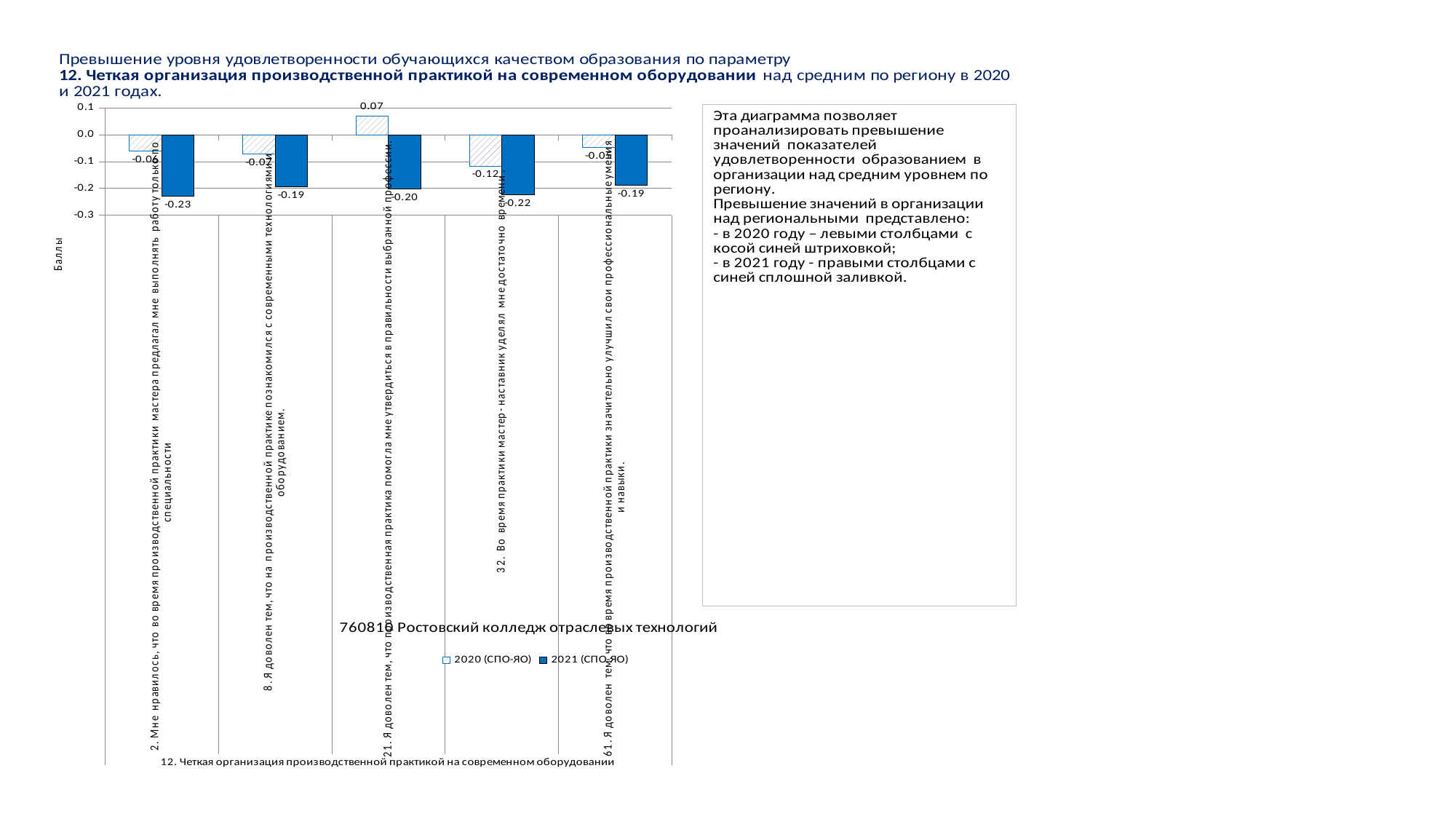
Is the 2020 (СПО-ЯО) value for item 61 greater or less than -0.1? greater Which item has the highest 2020 (СПО-ЯО) value? 21. Я доволен тем, что производственная практика помогла мне утвердиться в правильности выбранной профессии How many categories (survey items) are plotted on the chart? 5 What is the 2021 (СПО-ЯО) value for item 2 ("Мне нравилось, что во время производственной практики мастера предлагал мне выполнять работу только по специальности")? -0.23 How many series does the chart legend list? 2 What is the 2020 (СПО-ЯО) value for item 21 ("Я доволен тем, что производственная практика помогла мне утвердиться в правильности выбранной профессии")? 0.07 What is the 2021 (СПО-ЯО) value for item 32 ("Во время практики мастер-наставник уделял мне достаточно времени")? -0.22 Which item has the lowest 2021 (СПО-ЯО) value? 2. Мне нравилось, что во время производственной практики мастера предлагал мне выполнять работу только по специальности For item 21, what is the difference between the 2020 value (0.07) and the 2021 value (-0.20)? 0.27 What are the two legend entries of the chart? 2020 (СПО-ЯО) and 2021 (СПО-ЯО) What kind of chart is shown on the slide? Bar chart Which is larger: the 2021 value for item 8 or the 2021 value for item 32? Item 8 (-0.19)